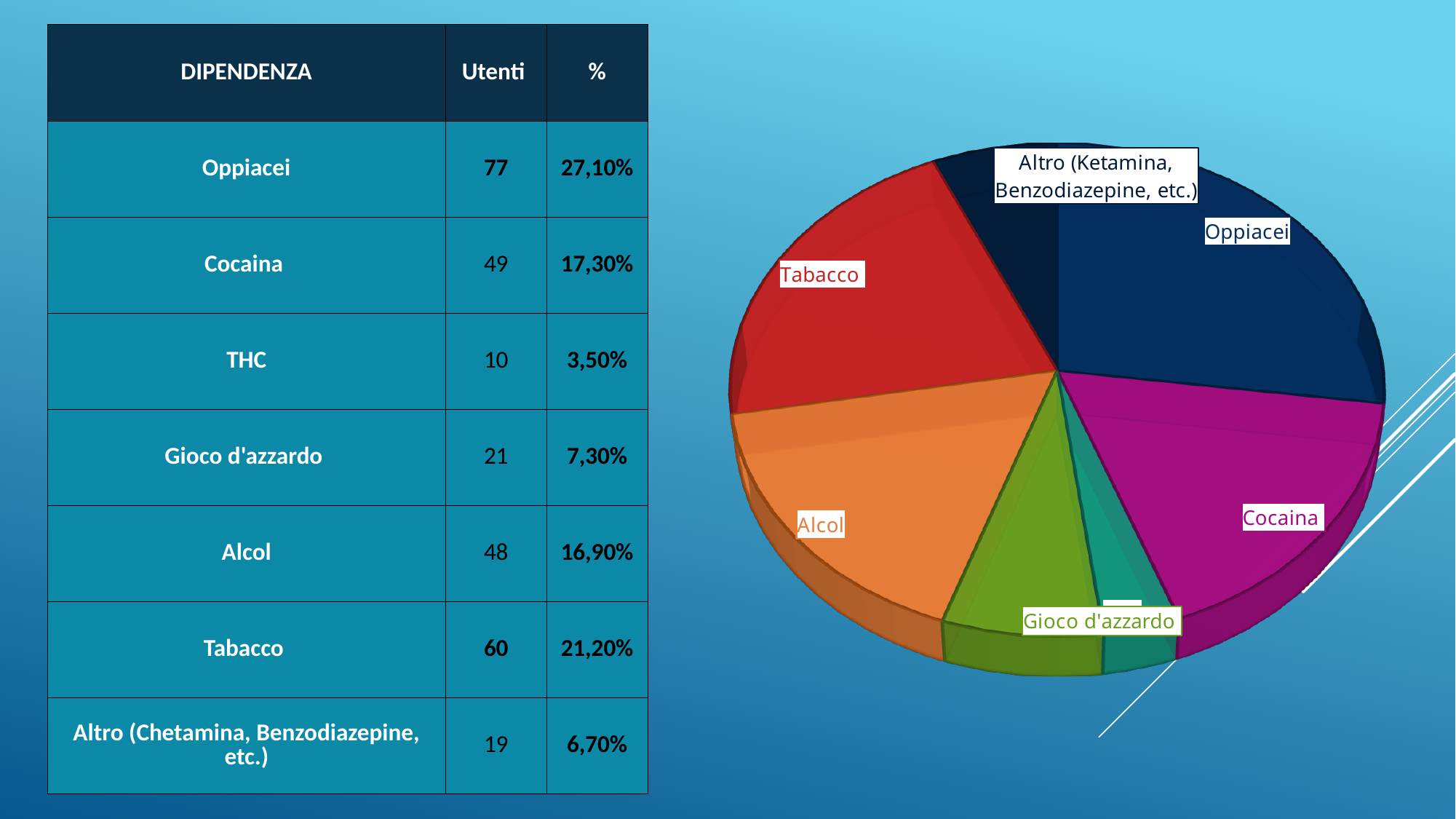
Which category has the largest slice in the pie chart? Oppiacei How many dependency categories does the table list? 7 What colour is the Cocaina slice in the pie chart? magenta What is the difference in users between Oppiacei and Tabacco? 17 What kind of chart is shown on the right of the slide? pie chart How many users are listed for Gioco d'azzardo? 21 Which slice is larger in the pie chart, Tabacco or Cocaina? Tabacco Which slice of the pie chart is labelled in red text? Tabacco What is the percentage listed for Alcol? 16,90% What percentage share does Oppiacei have according to the table? 27,10% How many users (Utenti) are listed for Tabacco? 60 According to the table, which dependency has the smallest share? THC